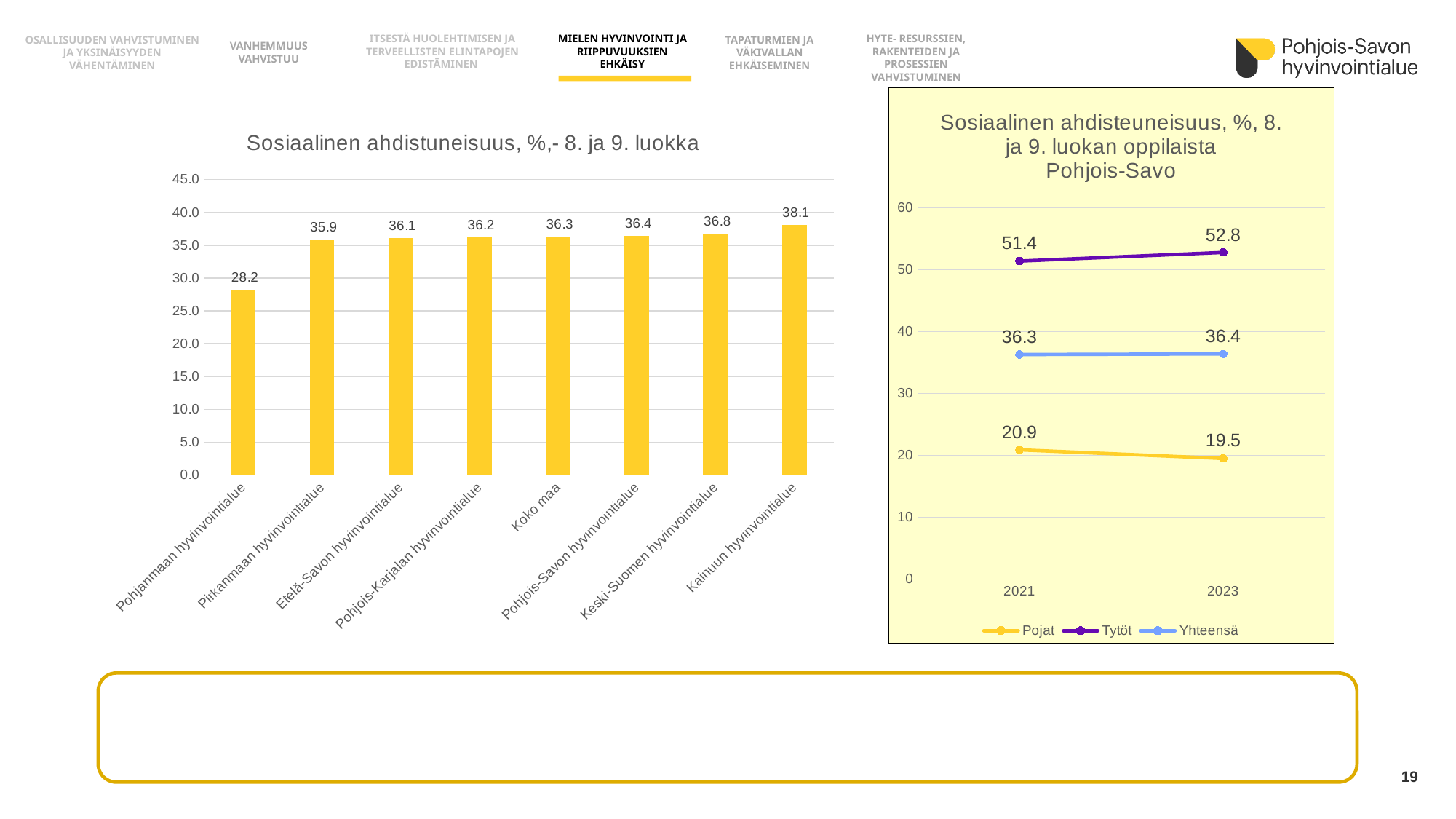
In the line chart on the right, what is the value for Tytöt in 2023? 52.8 In the bar chart on the left, what is the difference between Kainuun hyvinvointialue and Pohjanmaan hyvinvointialue? 9.9 In the bar chart on the left, which category has the highest value? Kainuun hyvinvointialue In the line chart on the right, does the value for Pojat rise or fall from 2021 to 2023? Falls In the bar chart on the left, which category has the lowest value? Pohjanmaan hyvinvointialue In the bar chart on the left, what is the value for Pohjanmaan hyvinvointialue? 28.2 In the line chart on the right, which series is higher in 2023, Yhteensä or Pojat? Yhteensä In the bar chart on the left, what is the value for Koko maa? 36.3 In the line chart on the right, how many series does the legend list? 3 What kind of chart is the chart on the left? Bar chart In the bar chart on the left, how many categories are shown? 8 In the line chart on the right, what is the difference between Tytöt and Pojat in 2021? 30.5